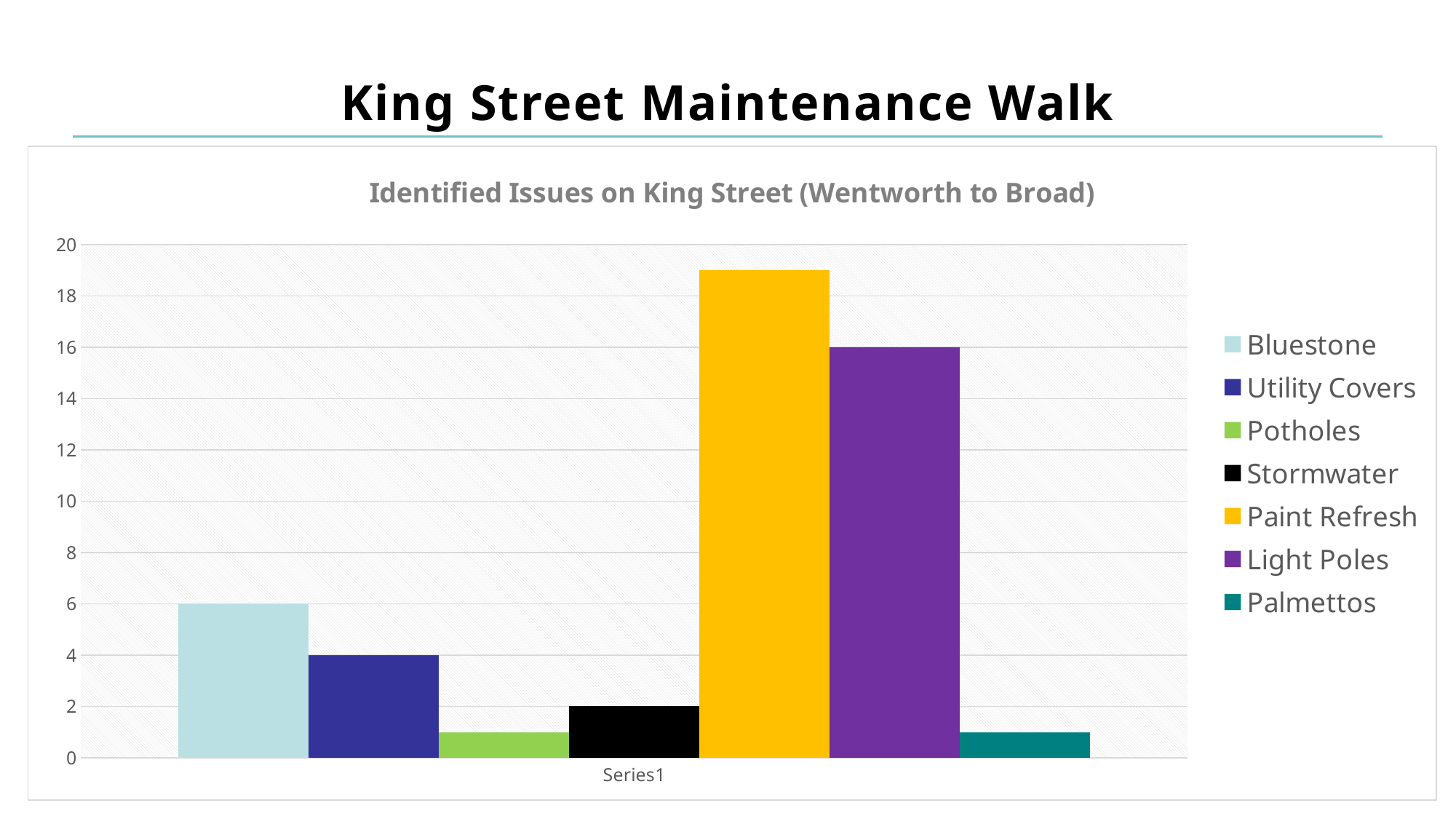
What is the value for Stormwater? 2 What is the difference between the value for Light Poles and the value for Bluestone? 10 Which is larger, the value for Bluestone or the value for Utility Covers? Bluestone Is the value for Paint Refresh greater or less than 18? greater What type of chart is shown on the slide? Bar chart How many series does the legend list? 7 What is the value for Utility Covers? 4 What is the value for Bluestone? 6 Which series has the highest value? Paint Refresh Is the value for Potholes greater or less than 2? less What is the title of the chart? Identified Issues on King Street (Wentworth to Broad) What is the value for Light Poles? 16